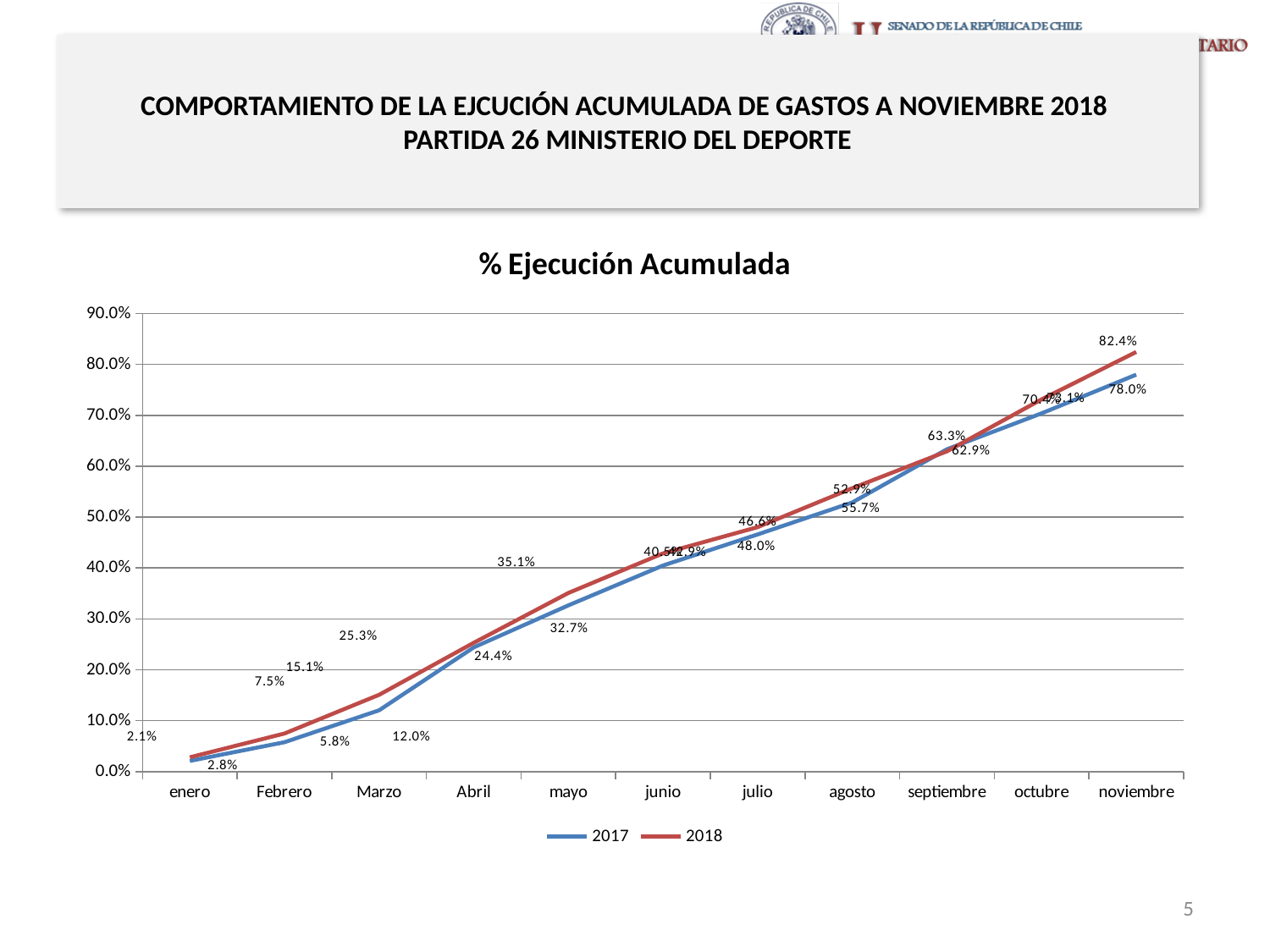
How many months are shown on the x axis? 11 In which month does the 2018 series reach its highest value? noviembre What kind of chart is shown on the slide? line chart How many series does the legend list? 2 In which month is the 2017 series at its lowest value? enero Do the values rise or fall from enero to noviembre? rise What is the value for 2017 in noviembre? 78.0% In noviembre, which series has the larger value, 2017 or 2018? 2018 Is the value for 2018 in Abril greater or less than 30%? less What is the difference between the 2018 and 2017 values in noviembre? 4.4% What is the value for 2018 in noviembre? 82.4% What is the title of the chart? % Ejecución Acumulada